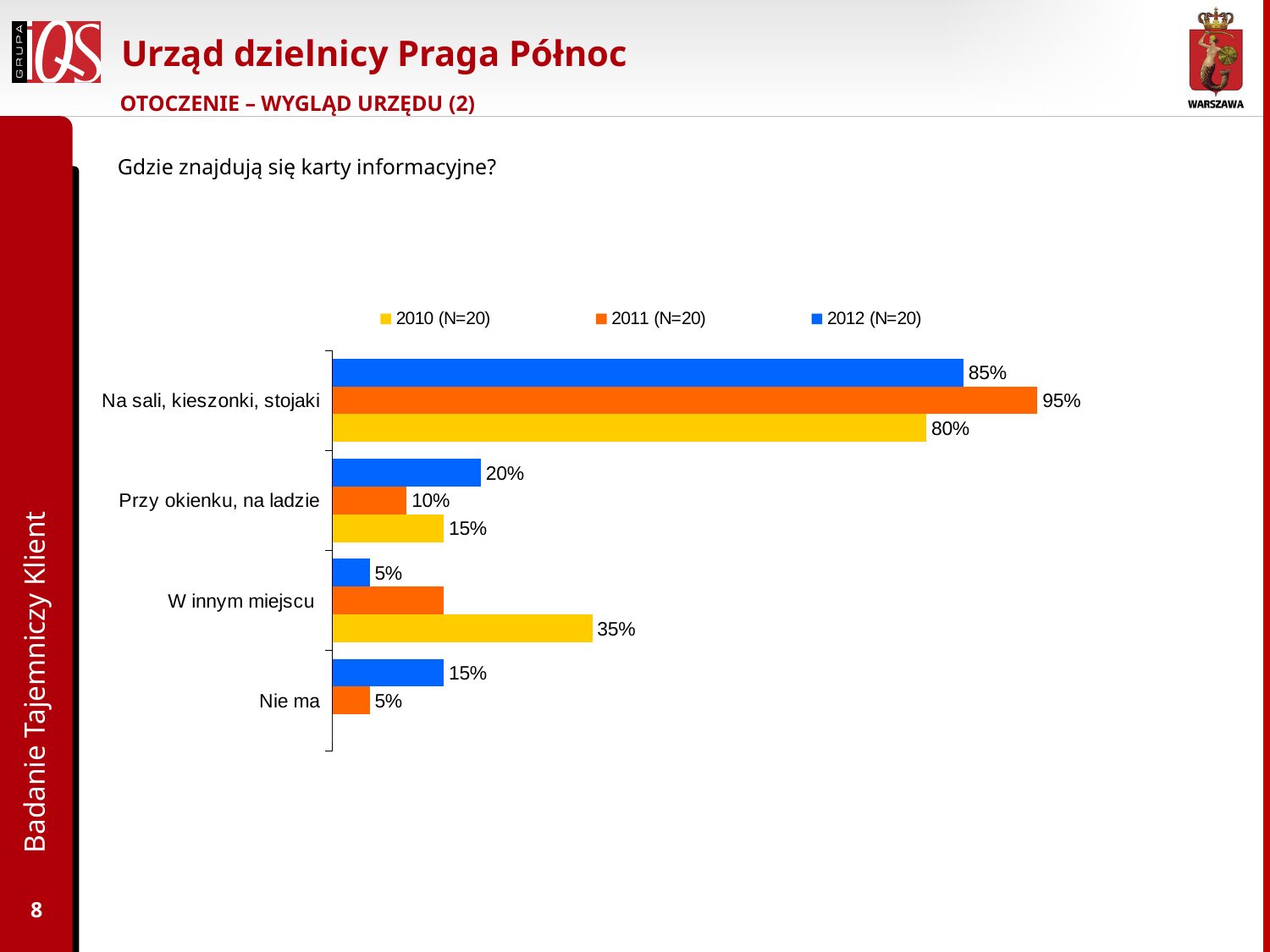
What is the difference between the 2011 and 2012 values for 'Na sali, kieszonki, stojaki'? 10% What is the value for 'Przy okienku, na ladzie' in 2012 (N=20)? 20% What is the value for 'Na sali, kieszonki, stojaki' in 2011 (N=20)? 95% What is the value for 'W innym miejscu' in 2010 (N=20)? 35% What type of chart is shown on the slide? bar chart What question is the chart answering, according to the text above it? Gdzie znajdują się karty informacyjne? Which is larger for 'Przy okienku, na ladzie': the 2010 value or the 2011 value? 2010 How many series does the legend list? 3 How many categories are shown on the chart? 4 Which category has the highest value for 2012 (N=20)? Na sali, kieszonki, stojaki What is the value for 'Nie ma' in 2011 (N=20)? 5% What is the value for 'Na sali, kieszonki, stojaki' in 2010 (N=20)? 80%